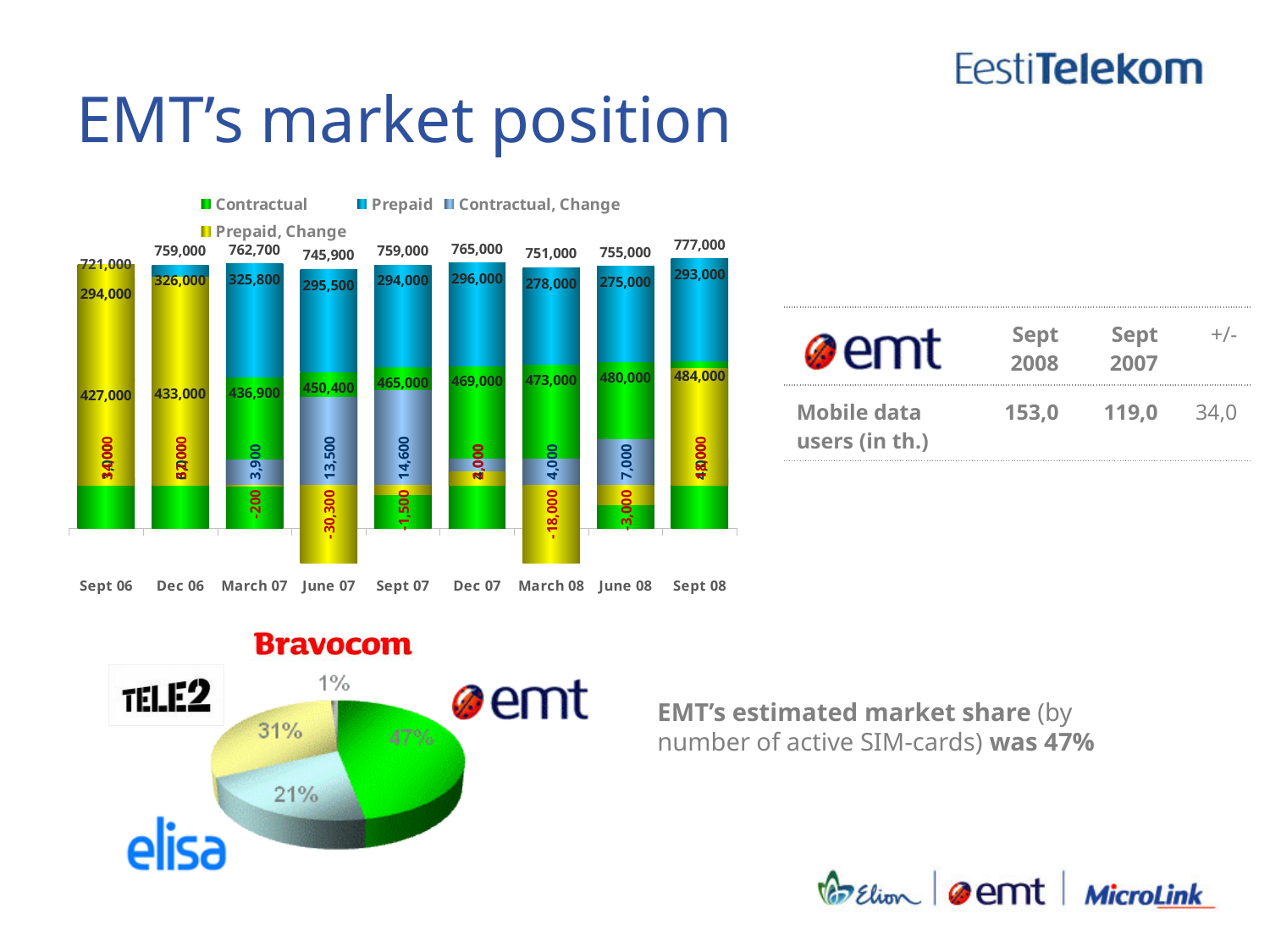
In the stacked bar chart, which period has the lowest total? Sept 06 In the stacked bar chart, which period has the highest total? Sept 08 In the pie chart at the bottom left, what share does Tele2 have? 31% In the stacked bar chart, what is the Contractual value for June 07? 450,400 In the stacked bar chart, is the Prepaid value larger for Dec 06 or for Sept 08? Dec 06 In the stacked bar chart, what is the Prepaid value for Dec 06? 326,000 In the stacked bar chart, what is the Prepaid, Change value for June 07? -30,300 How many series does the legend of the stacked bar chart list? 4 In the stacked bar chart, what is the total number of subscribers shown for Sept 08? 777,000 In the stacked bar chart, what is the difference between the Contractual value for Sept 08 and for Sept 06? 57,000 In the stacked bar chart, does the Contractual value rise or fall from Sept 06 to Sept 08? rise How many periods are shown on the x axis of the stacked bar chart? 9